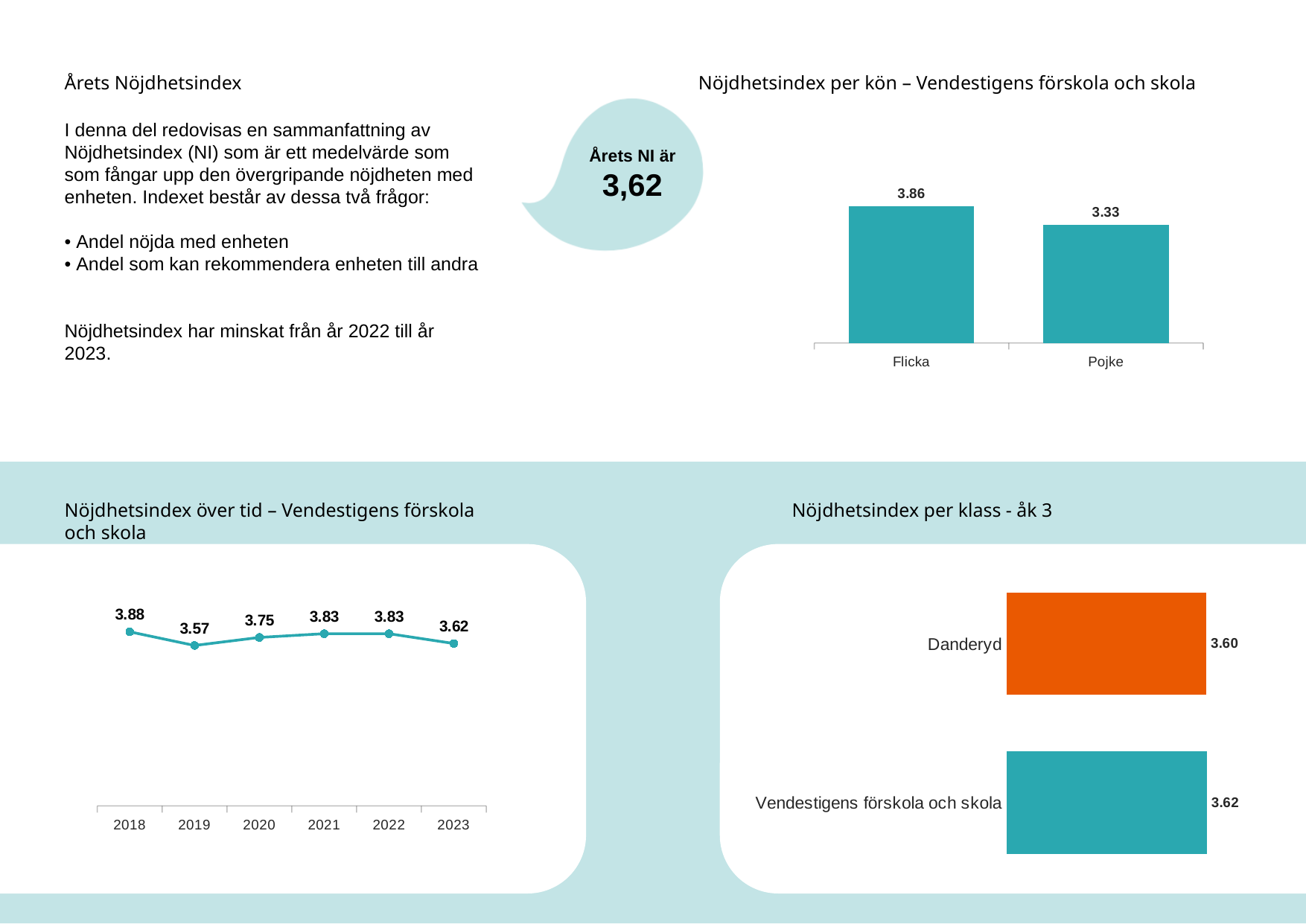
In the 'Nöjdhetsindex över tid' chart, which year has the highest value? 2018 In the 'Nöjdhetsindex över tid' chart, which year has the lowest value? 2019 In the 'Nöjdhetsindex per kön' chart, what is the value for Pojke? 3.33 In the 'Nöjdhetsindex per kön' chart, which category has the higher value, Flicka or Pojke? Flicka In the 'Nöjdhetsindex per kön' chart, what is the difference between the values for Flicka and Pojke? 0.53 In the 'Nöjdhetsindex över tid' chart, how many years are plotted? 6 In the 'Nöjdhetsindex per klass - åk 3' chart, what is the value for Danderyd? 3.60 What kind of chart is 'Nöjdhetsindex per kön – Vendestigens förskola och skola'? Bar chart In the 'Nöjdhetsindex per kön' chart, what is the value for Flicka? 3.86 In the 'Nöjdhetsindex per klass - åk 3' chart, what colour is the bar for Danderyd? Orange In the 'Nöjdhetsindex över tid' chart, what is the difference between the values for 2022 and 2023? 0.21 In the 'Nöjdhetsindex över tid' chart, what is the value for 2019? 3.57